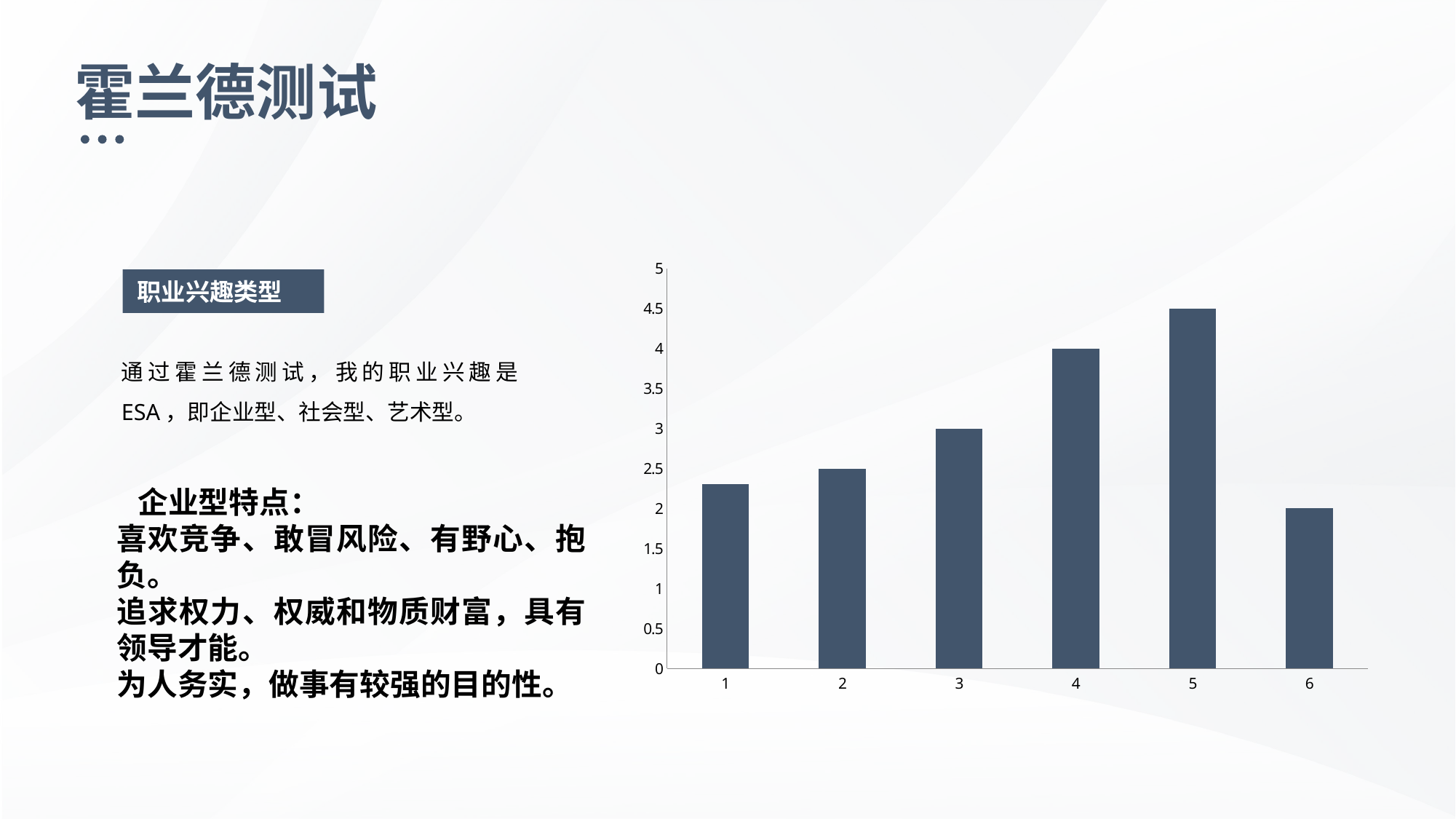
What is the value for category 6? 2 Do the values rise or fall from category 1 to category 5? rise What is the value for category 3? 3 Is the value for category 1 greater or less than 2? greater Which is larger, the value for category 2 or the value for category 4? category 4 Which category has the lowest bar in the chart? 6 What is the value for category 5? 4.5 What is the difference between the values for category 5 and category 6? 2.5 What is the value for category 4? 4 What kind of chart is shown on the slide? bar chart How many bars (categories) does the chart show? 6 Which category has the highest bar in the chart? 5